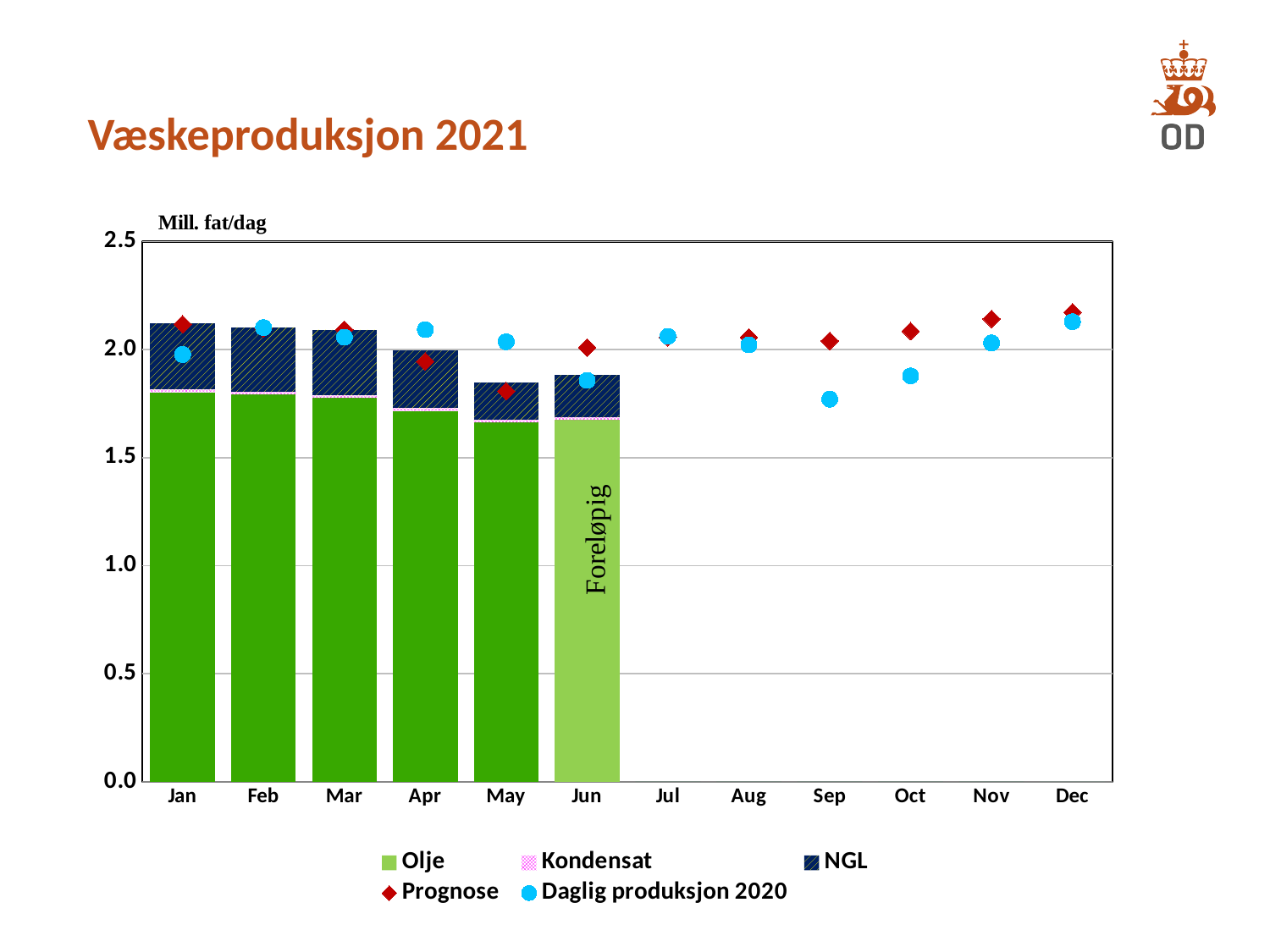
Which month has the lowest Daglig produksjon 2020 value? Sep How many series does the legend list? 5 Is the Prognose value for Dec greater or less than 2.0? greater Is the total stacked bar for May greater or less than 2.0? less Is the Daglig produksjon 2020 value for Sep greater or less than 2.0? less How many months are shown on the x axis? 12 How many months have stacked bars plotted? 6 What kind of chart is shown on the slide? Stacked bar chart with point markers Which is larger, the total stacked bar for Jan or for May? Jan Do the stacked bars rise or fall from Jan to May? fall What unit is shown above the y axis? Mill. fat/dag